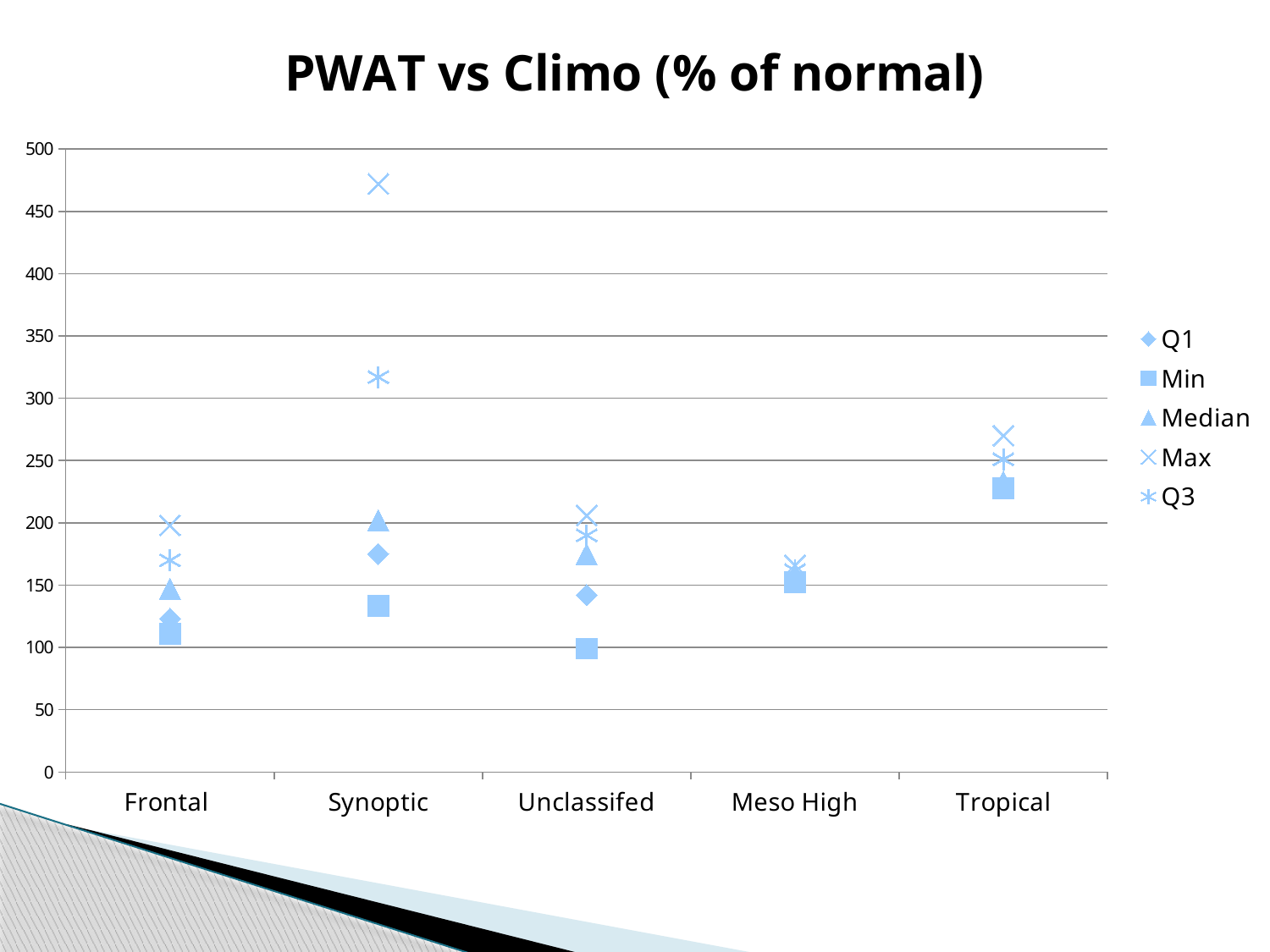
How many categories are shown on the x axis? 5 Which category has the lowest Min value? Unclassifed Is the Q3 value for Synoptic greater or less than 300? greater Which category has the highest Min value? Tropical Is the Min value for Tropical greater or less than 200? greater Is the Max value for Synoptic greater or less than 450? greater What kind of chart is shown on the slide? scatter chart How many series does the legend list? 5 Which category has the highest Max value? Synoptic Which is larger, the Max value for Synoptic or the Max value for Tropical? Synoptic What is the title of the chart? PWAT vs Climo (% of normal)